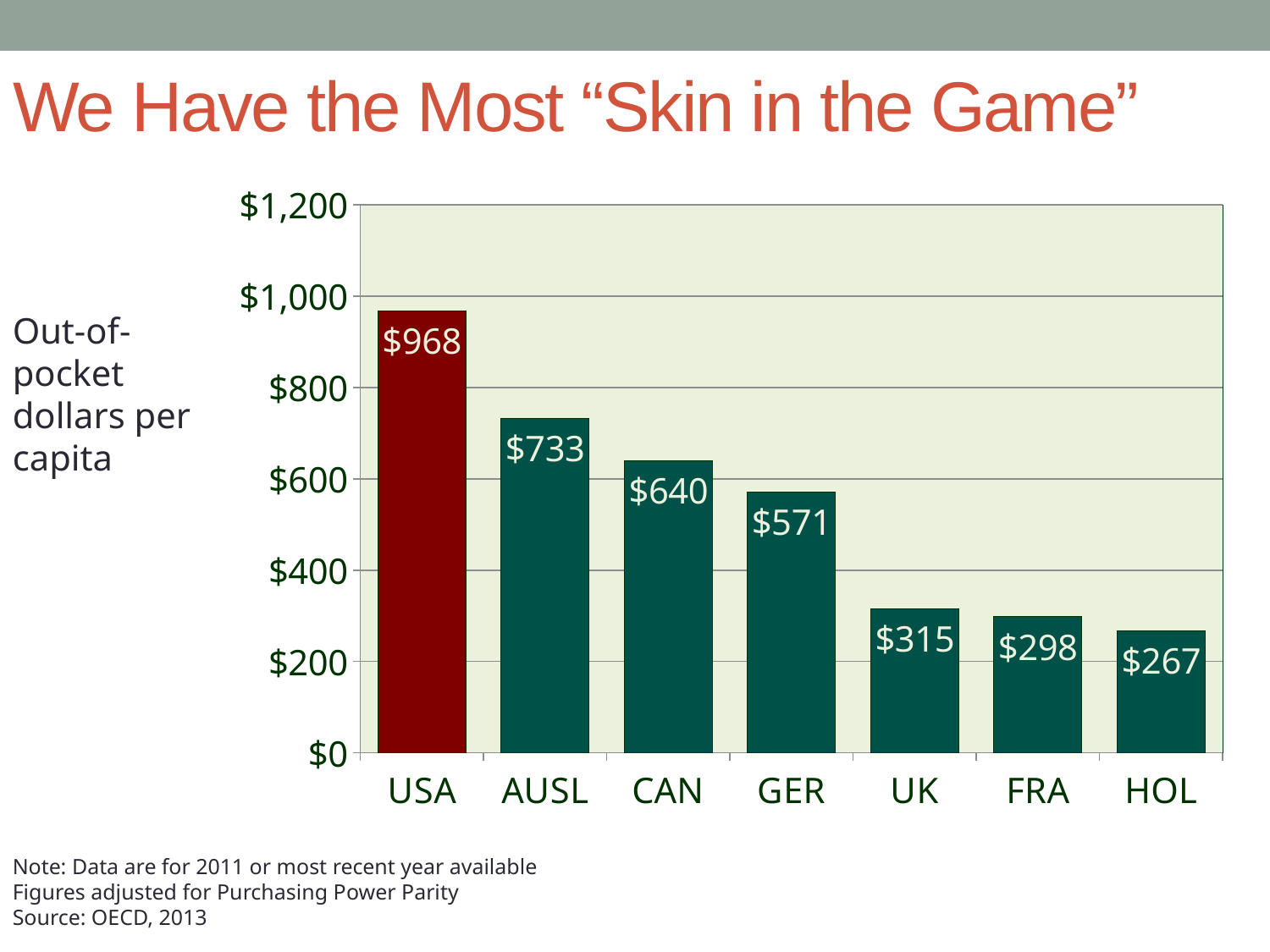
What kind of chart is shown on the slide? bar chart How many countries are shown on the chart? 7 Which country has the lowest out-of-pocket dollars per capita? HOL What is the value shown for HOL? $267 Is the value for AUSL greater or less than $800? less What is the value shown for GER? $571 What is the difference between the values for UK and FRA? $17 Which country has the highest out-of-pocket dollars per capita? USA Which has a larger value, CAN or GER? CAN What is the difference between the values for USA and AUSL? $235 What is the out-of-pocket dollars per capita value for USA? $968 Which bar is coloured differently (dark red) from the others? USA